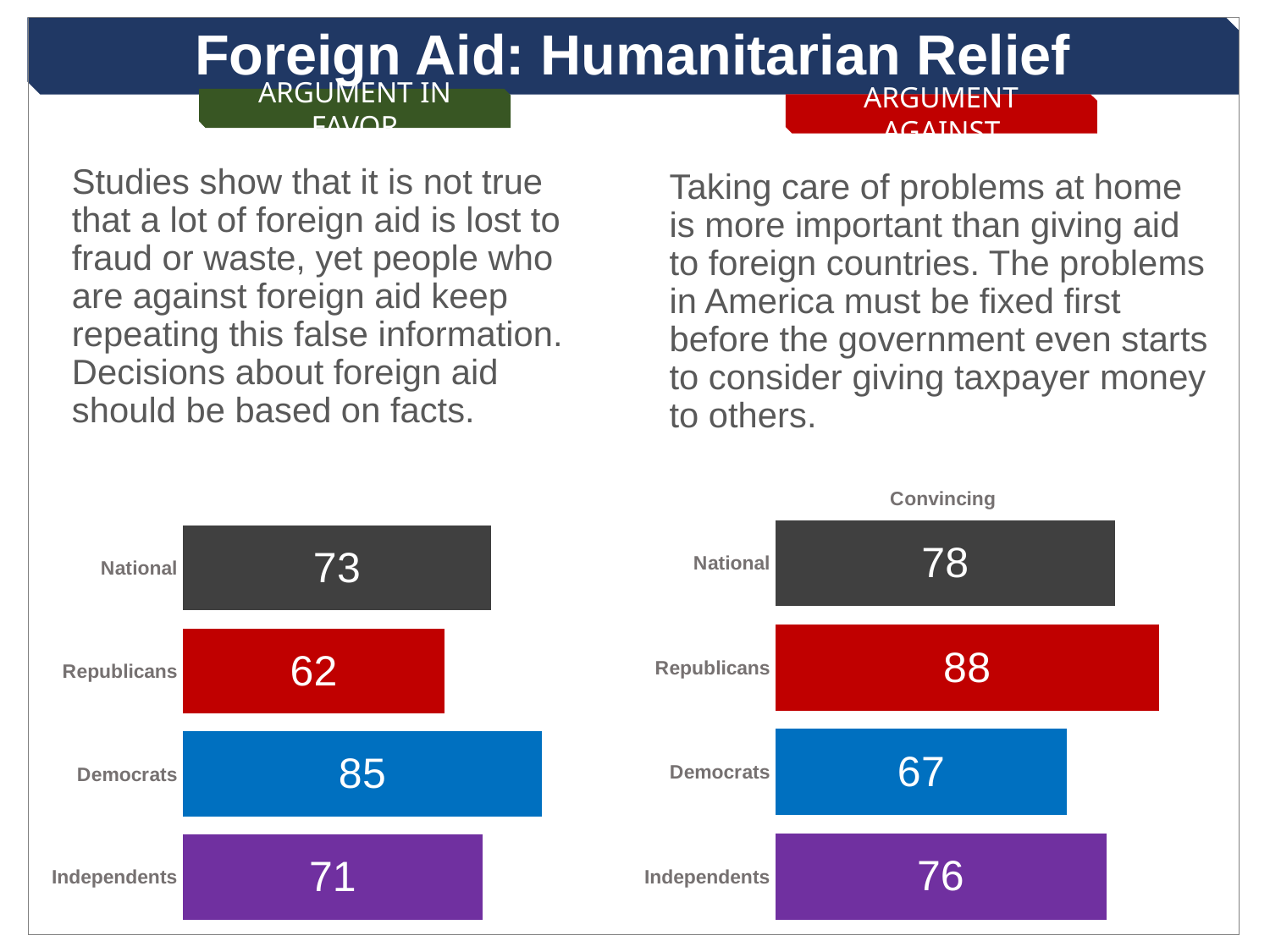
In the right chart (Argument Against), what is the difference between the Republicans value and the Democrats value? 21 In the left chart (Argument in Favor), what is the value for National? 73 In the right chart (Argument Against), what is the value for Independents? 76 In the right chart (Argument Against), what is the value for Republicans? 88 Which is larger: the National value in the left chart or the National value in the right chart? The right chart (78) What kind of chart is used on the left side of the slide? Bar chart In the right chart (Argument Against), which category has the lowest value? Democrats How many categories are shown in the right chart (Argument Against)? 4 In the left chart (Argument in Favor), which category has the highest value? Democrats In the left chart (Argument in Favor), what is the difference between the Democrats value and the Republicans value? 23 In the left chart (Argument in Favor), which category has the lowest value? Republicans In the left chart (Argument in Favor), what is the value for Democrats? 85